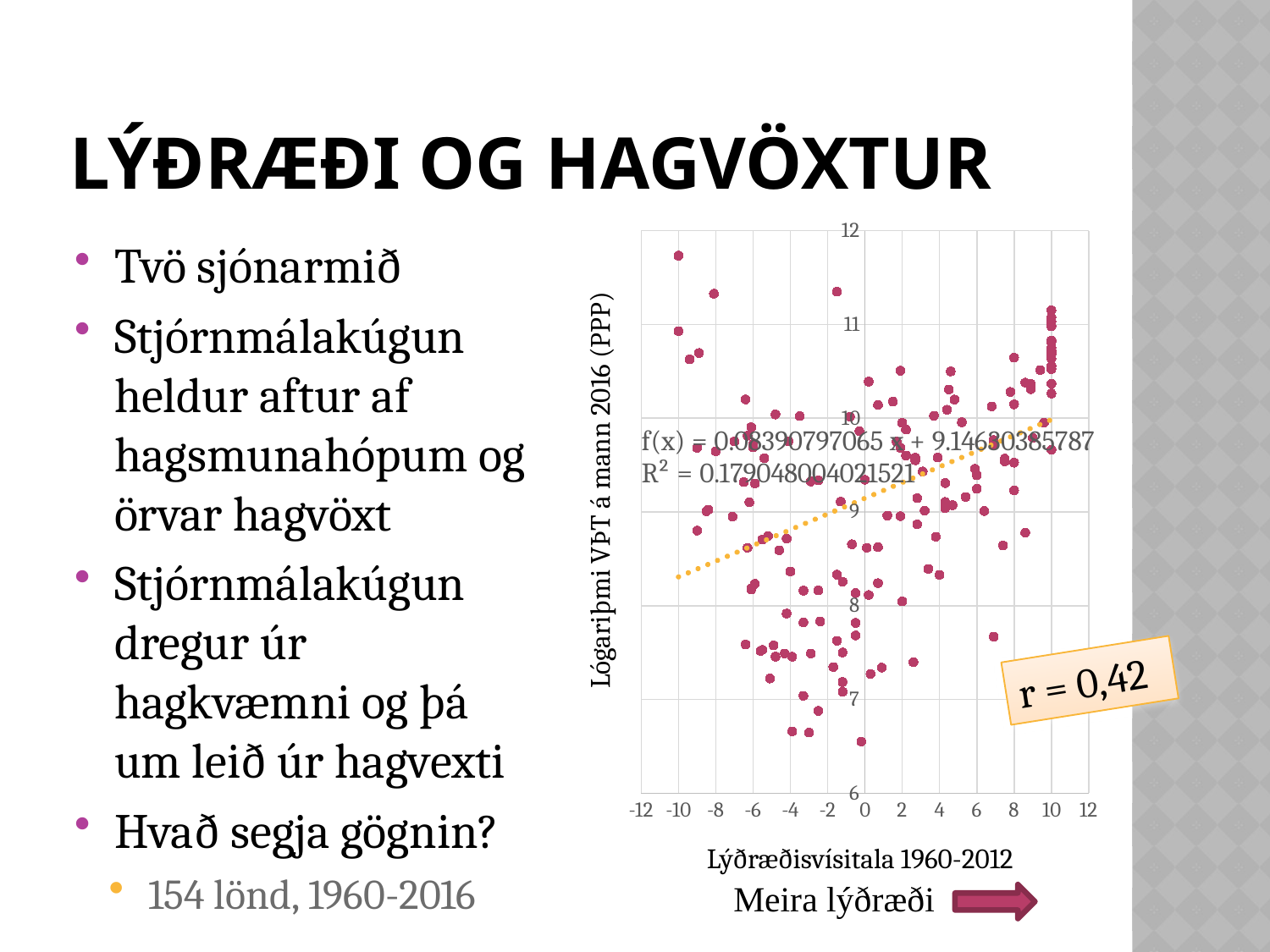
Is the slope of the fitted trendline positive or negative? positive What is the label of the x axis? Lýðræðisvísitala 1960-2012 Is the y value of the lowest plotted point greater or less than 7? less Do the plotted values tend to rise or fall as the democracy index on the x axis increases? rise What is the correlation coefficient r shown next to the chart? r = 0,42 What R² value is printed on the chart for the trendline? 0.179048004021521 What is the label of the y axis? Lógariþmi VÞT á mann 2016 (PPP) Is the y value of the highest plotted point greater or less than 11? greater What kind of chart is shown on the slide? scatter plot What is the maximum value shown on the y axis? 12 What is the minimum value shown on the x axis? -12 Is the intercept of the fitted trendline greater or less than 9? greater